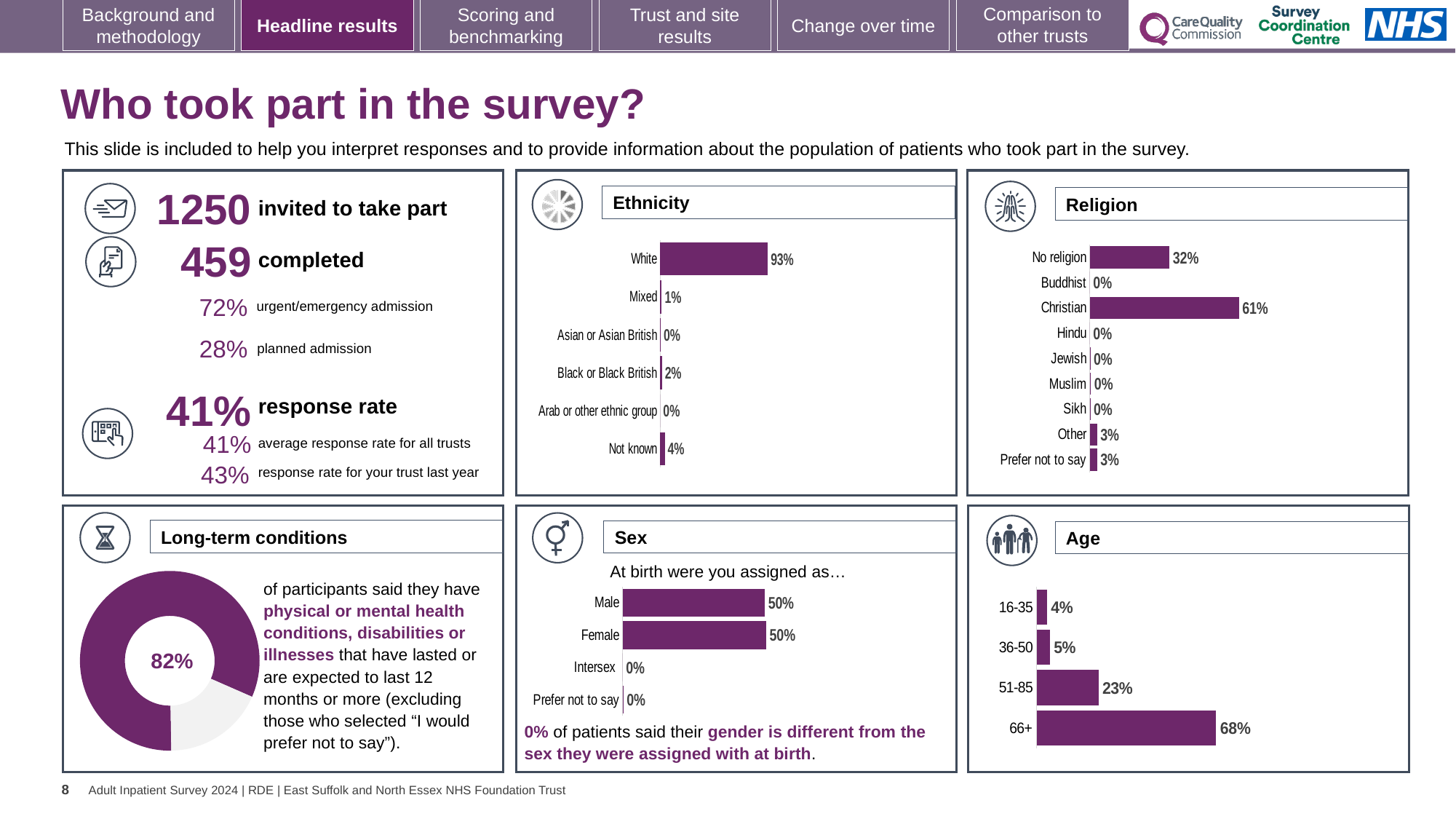
In the Religion chart, what percentage of participants were Christian? 61% In the Religion chart, how many categories are shown? 9 In the Long-term conditions chart, what share of participants said they have long-term conditions? 82% In the Age chart, which age group has the highest value? 66+ In the Ethnicity chart, what percentage of participants were White? 93% In the Age chart, do the values rise or fall as age increases from 16-35 to 66+? rise In the Age chart, what percentage of participants were aged 51-85? 23% In the Ethnicity chart, which category has the highest value? White In the Sex chart, what percentage of participants were assigned Female at birth? 50% In the Religion chart, what is the difference between the Christian and No religion values? 29% What kind of chart is used in the Long-term conditions panel? Doughnut chart In the Ethnicity chart, how many categories are shown? 6